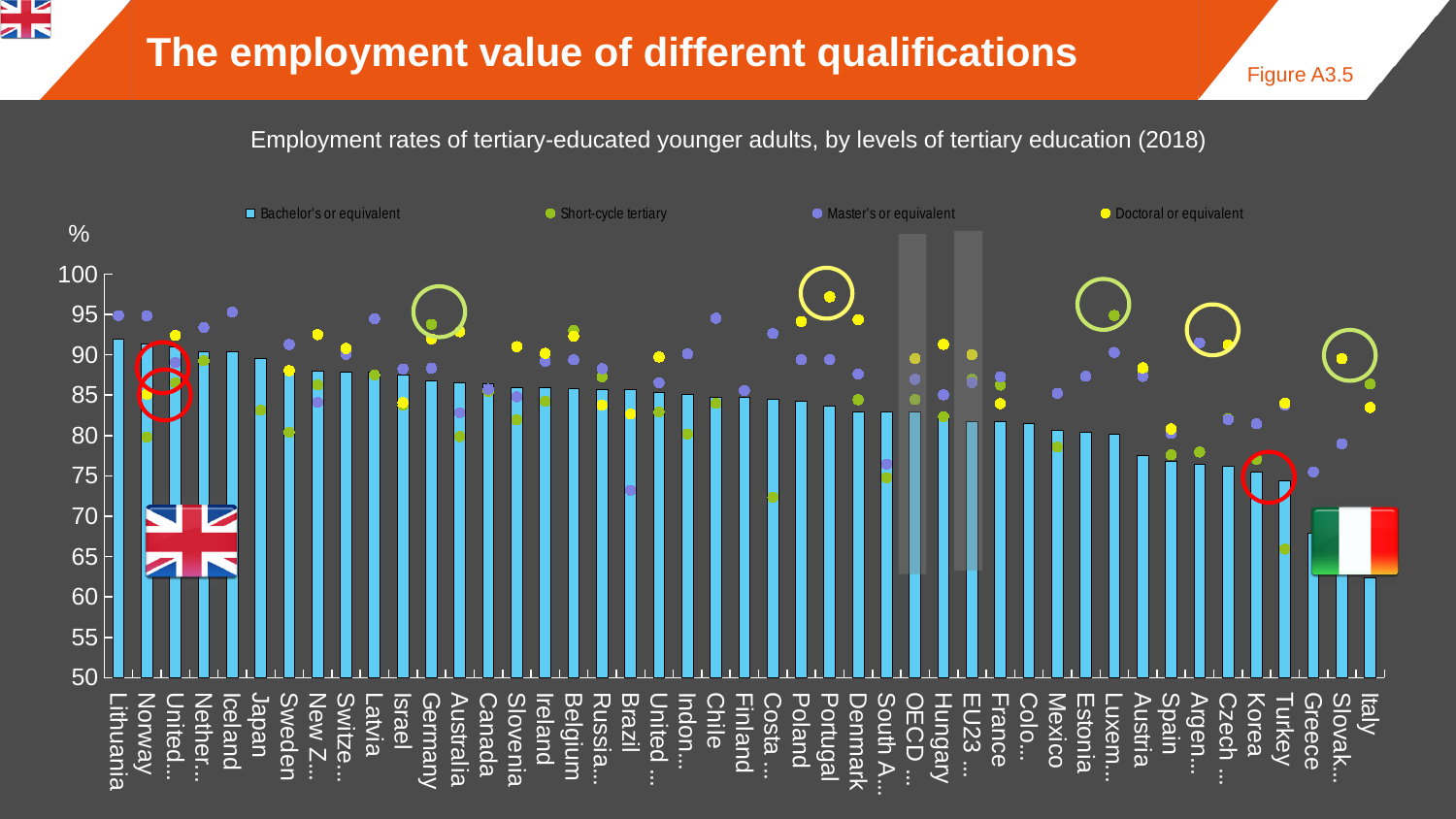
Is the Bachelor's or equivalent bar for Spain greater or less than 75%? greater What kind of chart is shown on the slide? Bar chart (with dot markers) Is the Bachelor's or equivalent bar for Greece greater or less than 70%? less Which series in the legend is shown with yellow markers? Doctoral or equivalent Is the Bachelor's or equivalent bar for Germany greater or less than 85%? greater Which country has the lowest Bachelor's or equivalent employment rate (shortest bar)? Italy Which has the larger Bachelor's or equivalent bar, Norway or Greece? Norway Do the Bachelor's or equivalent bars rise or fall moving from left to right along the x axis? fall Which country has the highest Bachelor's or equivalent employment rate (tallest bar)? Lithuania How many series does the legend list? 4